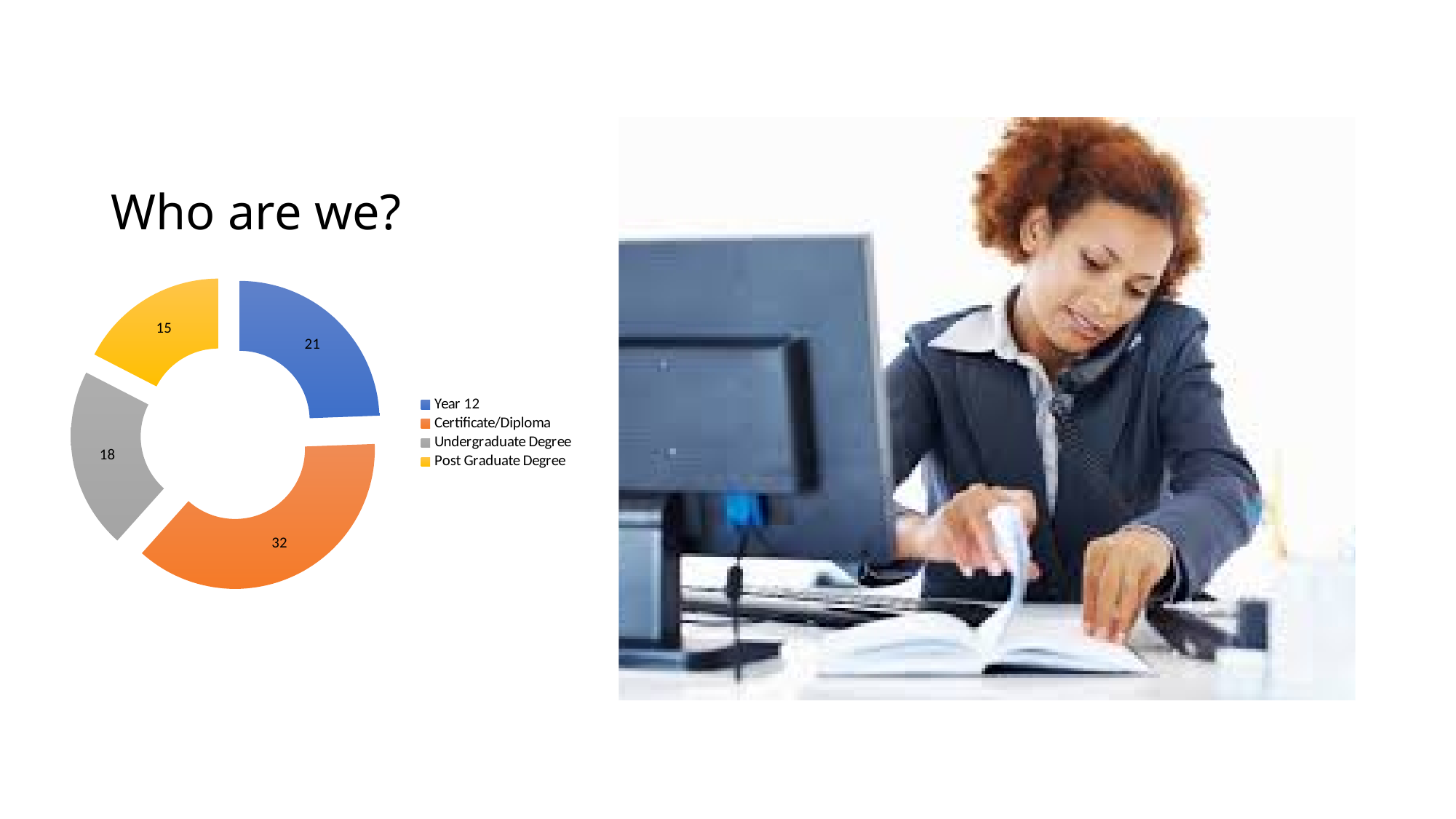
What is the total of all the values in the chart? 86 Which colour represents Undergraduate Degree in the chart? Grey What is the value for Undergraduate Degree? 18 Which category has the lowest value? Post Graduate Degree What is the difference between the values for Certificate/Diploma and Year 12? 11 What is the value for Certificate/Diploma? 32 How many categories does the chart show? 4 What is the value for Year 12? 21 What type of chart is shown on the slide? Doughnut chart Which category has the highest value? Certificate/Diploma What is the value for Post Graduate Degree? 15 Which is larger, the value for Undergraduate Degree or the value for Post Graduate Degree? Undergraduate Degree